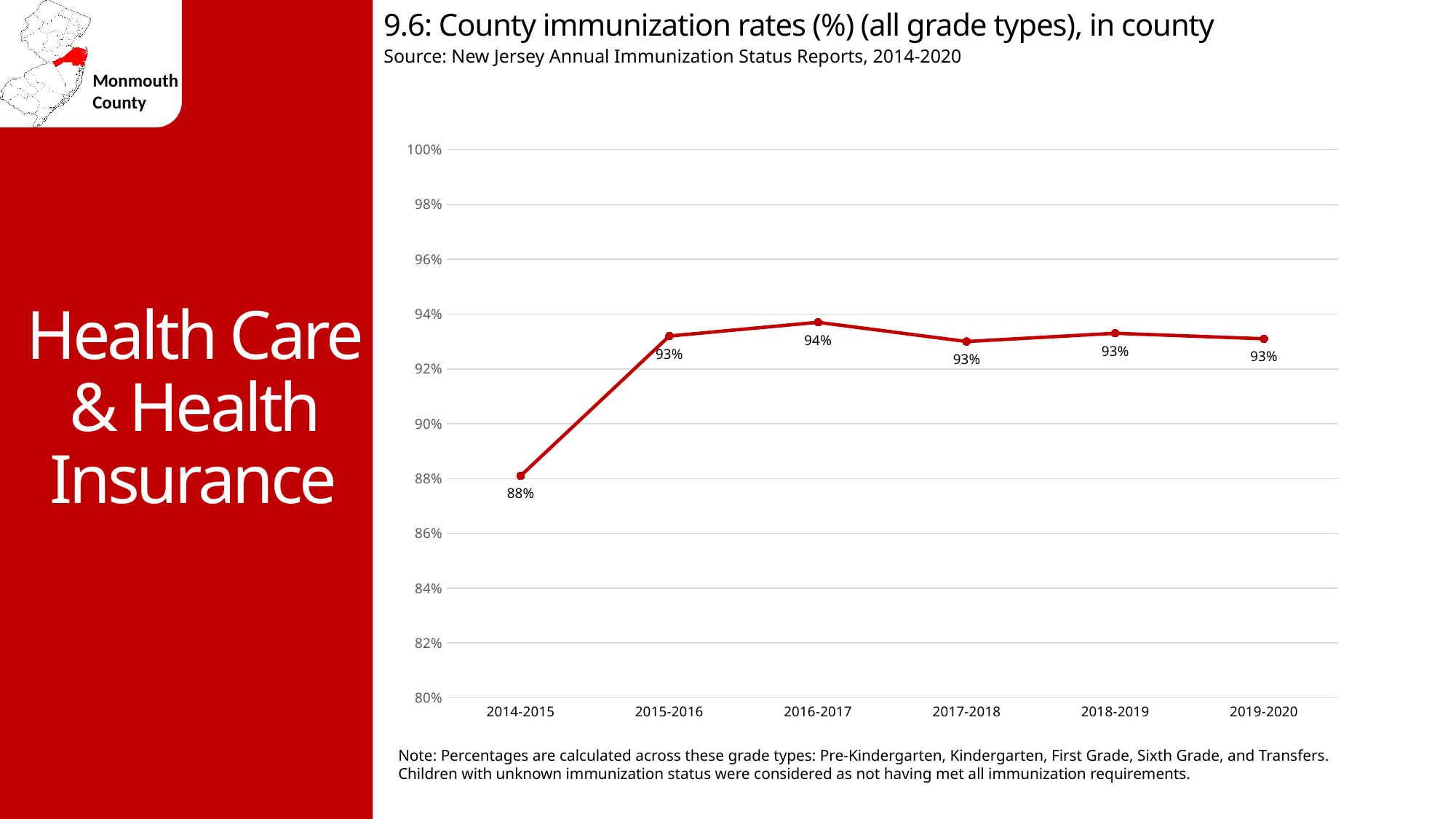
Which school year had the highest immunization rate? 2016-2017 Did the immunization rate rise or fall from 2014-2015 to 2015-2016? rise Is the immunization rate for 2014-2015 greater or less than 90%? less What was the county immunization rate in 2019-2020? 93% What is the difference in immunization rate between 2016-2017 and 2014-2015? 6% What was the county immunization rate in 2014-2015? 88% How many school years are plotted on the chart? 6 What is the source cited for the chart? New Jersey Annual Immunization Status Reports, 2014-2020 Which year had a higher immunization rate, 2014-2015 or 2015-2016? 2015-2016 Which school year had the lowest immunization rate? 2014-2015 What kind of chart is shown on the slide? line chart What was the county immunization rate in 2016-2017? 94%